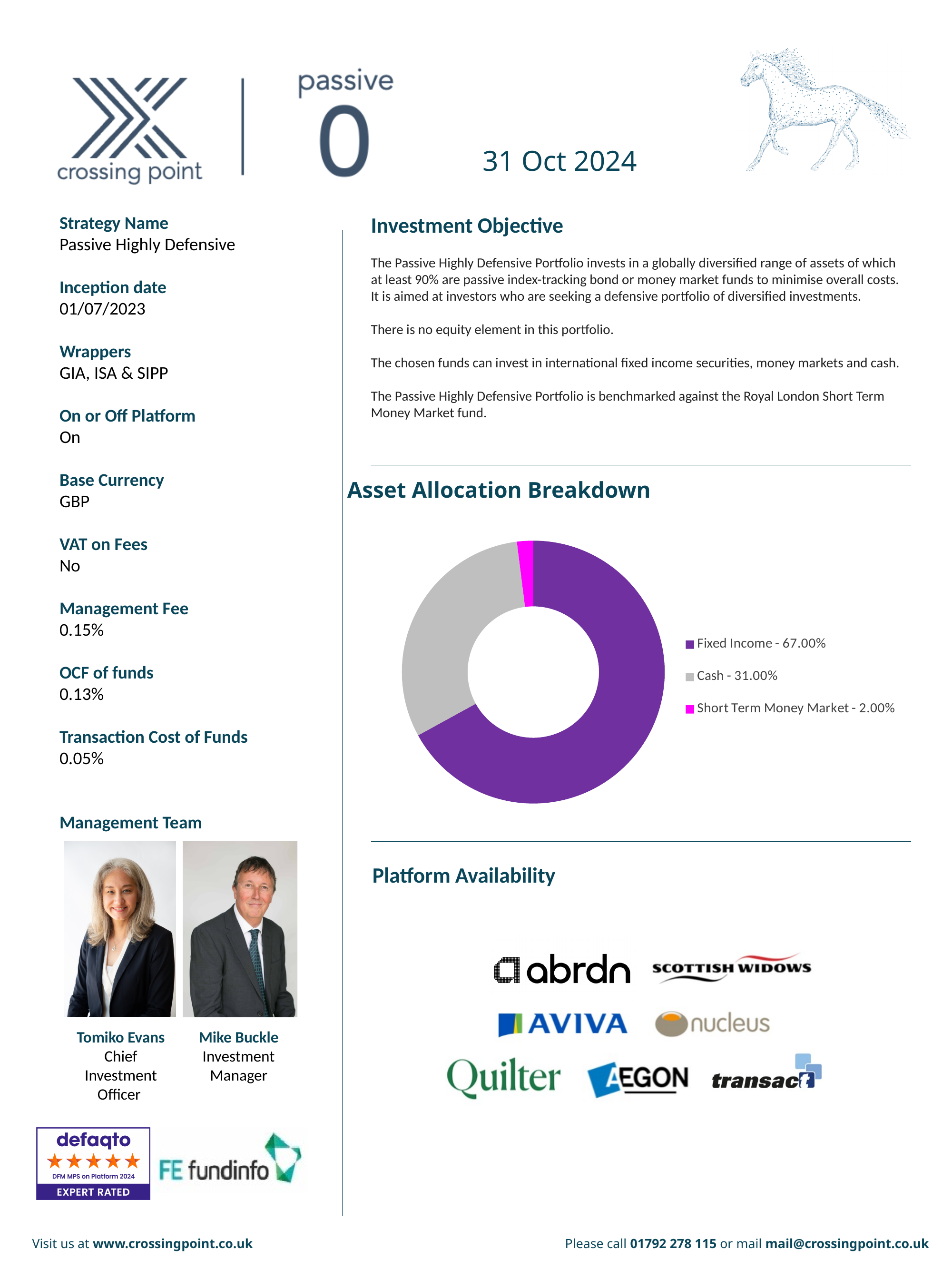
What share of the Asset Allocation Breakdown chart is Short Term Money Market? 2.00% In the Asset Allocation Breakdown chart, which is larger: Cash or Short Term Money Market? Cash What kind of chart is the Asset Allocation Breakdown? Doughnut (pie) chart What is the title of the chart on the slide? Asset Allocation Breakdown Which asset class has the smallest share in the Asset Allocation Breakdown chart? Short Term Money Market What colour represents Cash in the Asset Allocation Breakdown chart? Grey Which asset class has the largest share in the Asset Allocation Breakdown chart? Fixed Income How many asset classes are shown in the Asset Allocation Breakdown chart? 3 What share of the Asset Allocation Breakdown chart is Cash? 31.00% What is the combined share of Cash and Short Term Money Market in the Asset Allocation Breakdown chart? 33.00% What share of the Asset Allocation Breakdown chart is Fixed Income? 67.00% What is the difference between the Fixed Income and Cash shares in the Asset Allocation Breakdown chart? 36.00%